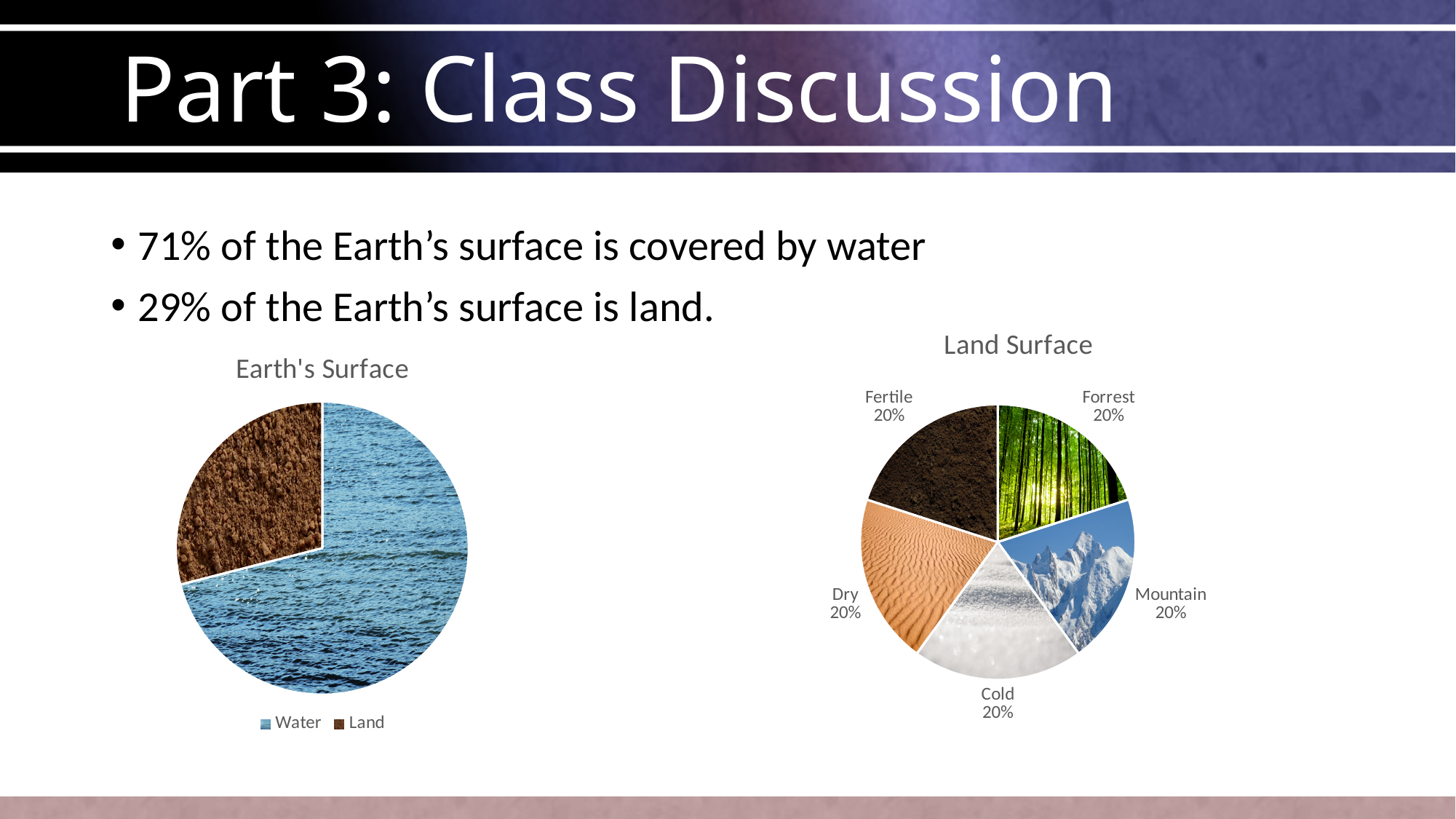
In the "Land Surface" chart, what share does the Mountain slice have? 20% What is the title of the pie chart on the right side of the slide? Land Surface In the "Land Surface" chart, what is the value shown for Dry? 20% What kind of chart is the "Land Surface" chart? pie chart How many slices does the "Land Surface" pie chart have? 5 What kind of chart is the "Earth's Surface" chart? pie chart According to the slide, what share of the Earth's surface is covered by water in the "Earth's Surface" chart? 71% In the "Earth's Surface" chart, which category has the largest slice? Water How many categories does the legend of the "Earth's Surface" chart list? 2 In the "Earth's Surface" chart, which slice is larger, Water or Land? Water According to the slide, what share of the Earth's surface is land in the "Earth's Surface" chart? 29% In the "Earth's Surface" chart, which category has the smallest slice? Land